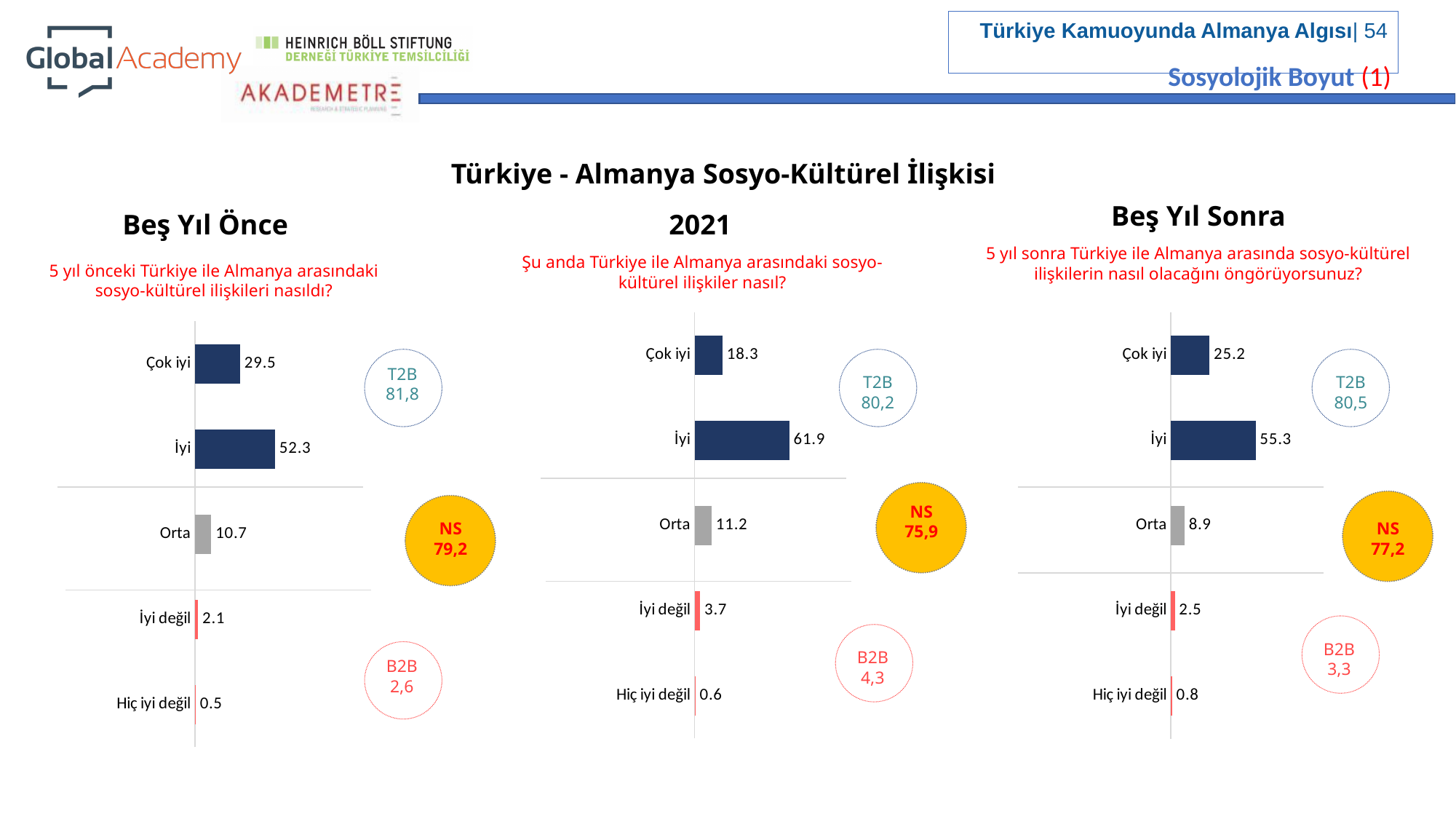
In the '2021' chart, which is larger: the value for Orta or the value for İyi değil? Orta In the 'Beş Yıl Önce' chart, what is the value for Hiç iyi değil? 0.5 In the 'Beş Yıl Sonra' chart, what is the value for Orta? 8.9 What kind of chart is the '2021' chart? Bar chart In the '2021' chart, what is the value for Çok iyi? 18.3 In the '2021' chart, what is the difference between the values for İyi değil and Hiç iyi değil? 3.1 In the 'Beş Yıl Sonra' chart, what is the difference between the values for İyi and Çok iyi? 30.1 In the '2021' chart, which category has the highest value? İyi What is the overall title shown above the three charts? Türkiye - Almanya Sosyo-Kültürel İlişkisi In the 'Beş Yıl Önce' chart, what is the value for İyi? 52.3 How many categories are shown in the 'Beş Yıl Önce' chart? 5 In the 'Beş Yıl Önce' chart, which category has the lowest value? Hiç iyi değil